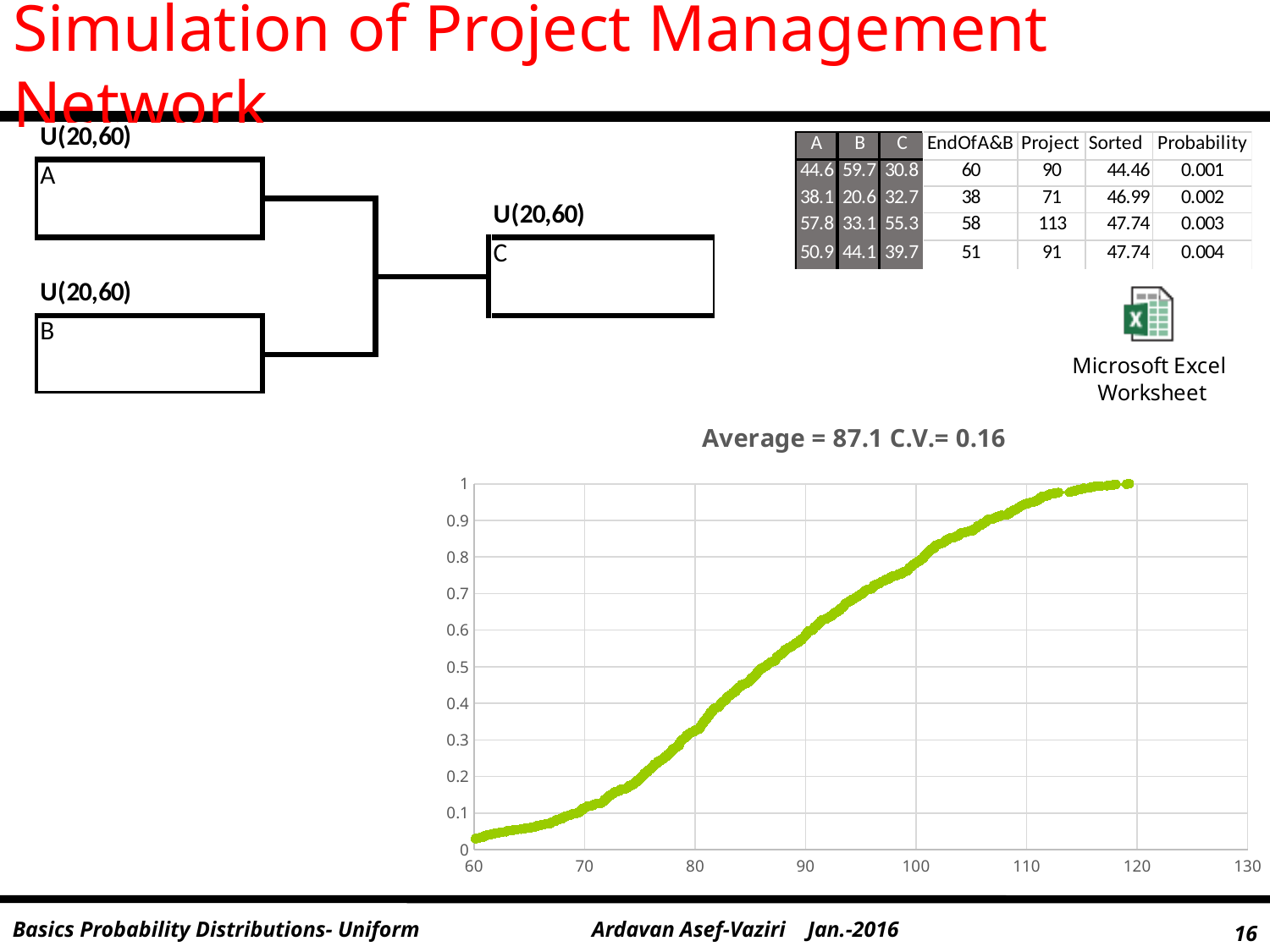
Do the plotted values rise or fall as the x axis increases from 60 to 120? rise Is the plotted value at x = 65 greater or less than 0.1? less Is the plotted value at x = 100 greater or less than 0.7? greater Is the plotted value at x = 110 greater or less than 0.9? greater What kind of chart is shown on the slide? scatter chart What is the highest value shown on the x axis of the chart? 130 What is the title of the chart? Average = 87.1 C.V.= 0.16